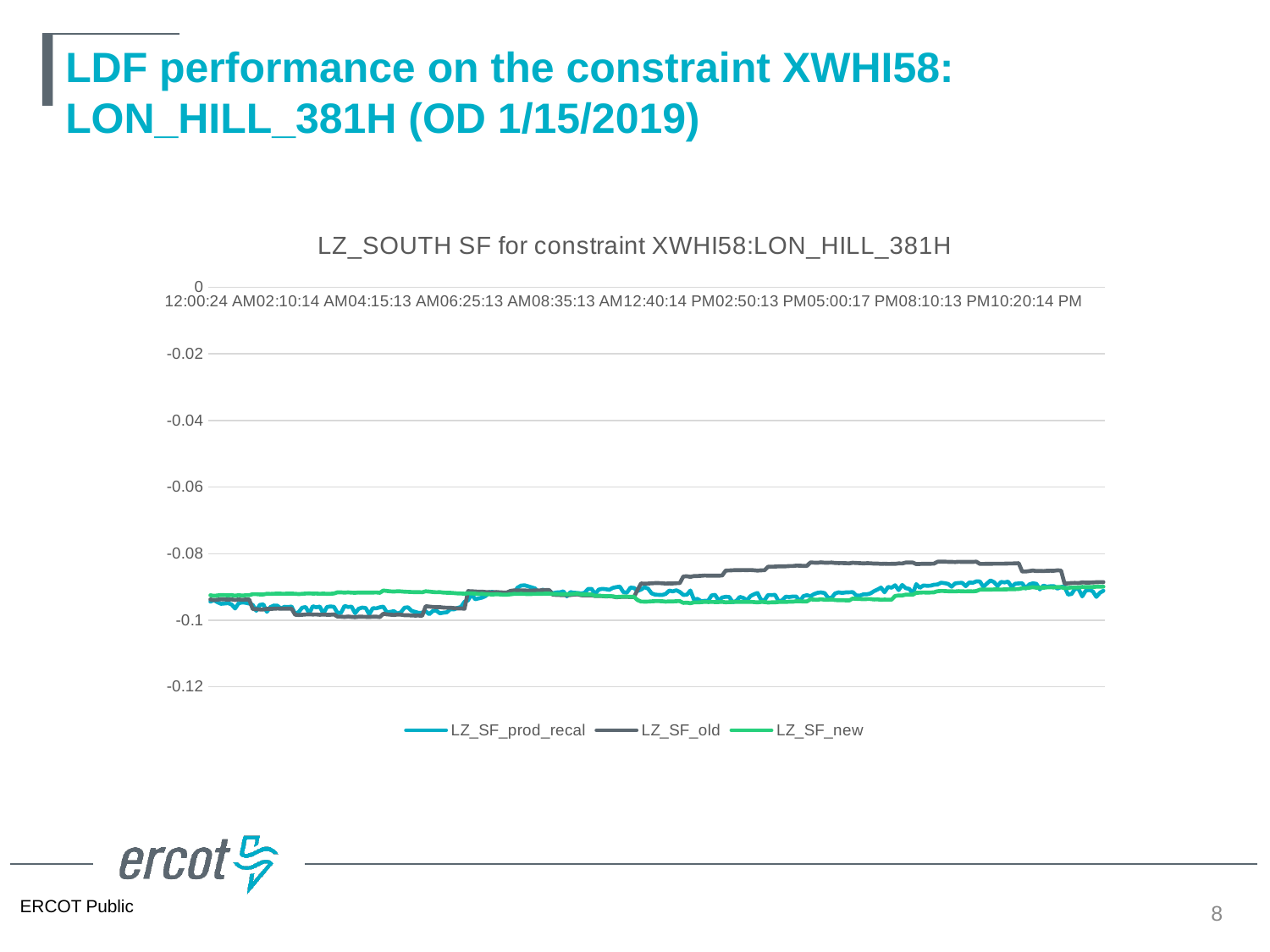
How many series does the legend list? 3 At 05:00:17 PM, which series has the higher value, LZ_SF_old or LZ_SF_new? LZ_SF_old What kind of chart is shown on the slide? line chart Is the value for LZ_SF_new at 12:40:14 PM greater or less than -0.06? less How many time labels are shown on the x axis? 10 What is the title of the chart? LZ_SOUTH SF for constraint XWHI58:LON_HILL_381H Is the value for LZ_SF_old at 05:00:17 PM greater or less than -0.1? greater Which series is drawn in green in the chart? LZ_SF_new Between 12:00:24 AM and 05:00:17 PM, does the LZ_SF_old series rise or fall? rise What is the lowest value labelled on the y axis? -0.12 At 04:15:13 AM, which series has the higher value, LZ_SF_old or LZ_SF_new? LZ_SF_new Is the value for LZ_SF_prod_recal at 02:10:14 AM greater or less than -0.08? less